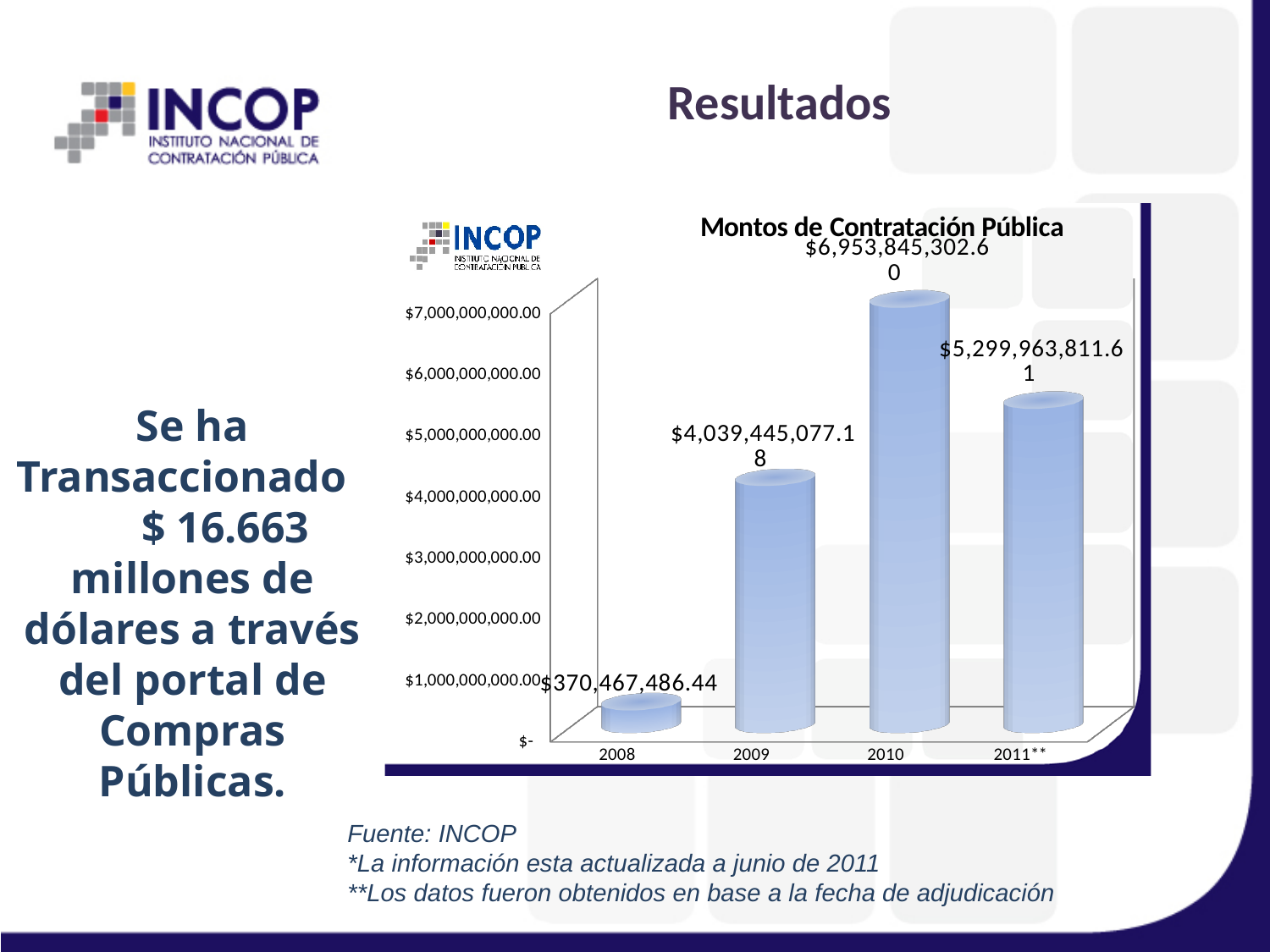
Is the value for 2008 greater or less than $1,000,000,000.00? less What is the value for 2008 in the chart? $370,467,486.44 Which is larger, the value for 2009 or the value for 2011**? 2011** What is the value for 2009 in the chart? $4,039,445,077.18 What is the value for 2010 in the chart? $6,953,845,302.60 What is the title of the chart? Montos de Contratación Pública What is the value for 2011** in the chart? $5,299,963,811.61 What type of chart is shown on the slide? Bar chart What is the difference between the values for 2010 and 2011**? $1,653,881,490.99 Which year has the highest value in the chart? 2010 Which year has the lowest value in the chart? 2008 How many years are shown on the x axis of the chart? 4